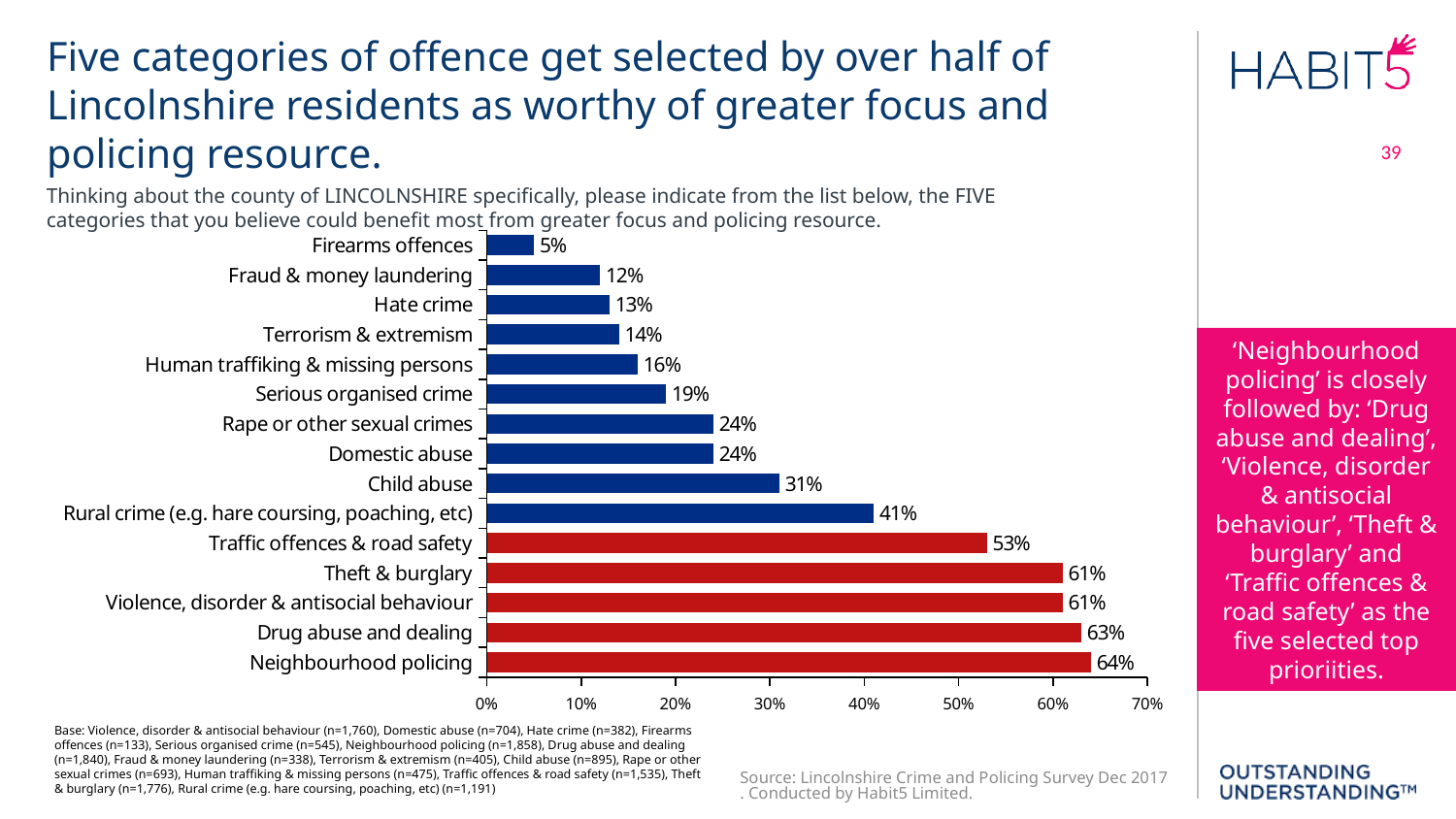
How many categories are shown in the chart? 15 What is the difference between the values for Drug abuse and dealing and Traffic offences & road safety? 10% What percentage is shown for Child abuse? 31% Which category has the highest value in the chart? Neighbourhood policing What percentage of Lincolnshire residents selected Neighbourhood policing? 64% What is the difference between the values for Neighbourhood policing and Firearms offences? 59% What kind of chart is shown on the slide? Bar chart Which is larger, the value for Serious organised crime or the value for Hate crime? Serious organised crime Which category has the lowest value in the chart? Firearms offences What is the value shown for Rural crime (e.g. hare coursing, poaching, etc)? 41% How many categories are shown with red bars? 5 What is the maximum value shown on the percentage axis? 70%